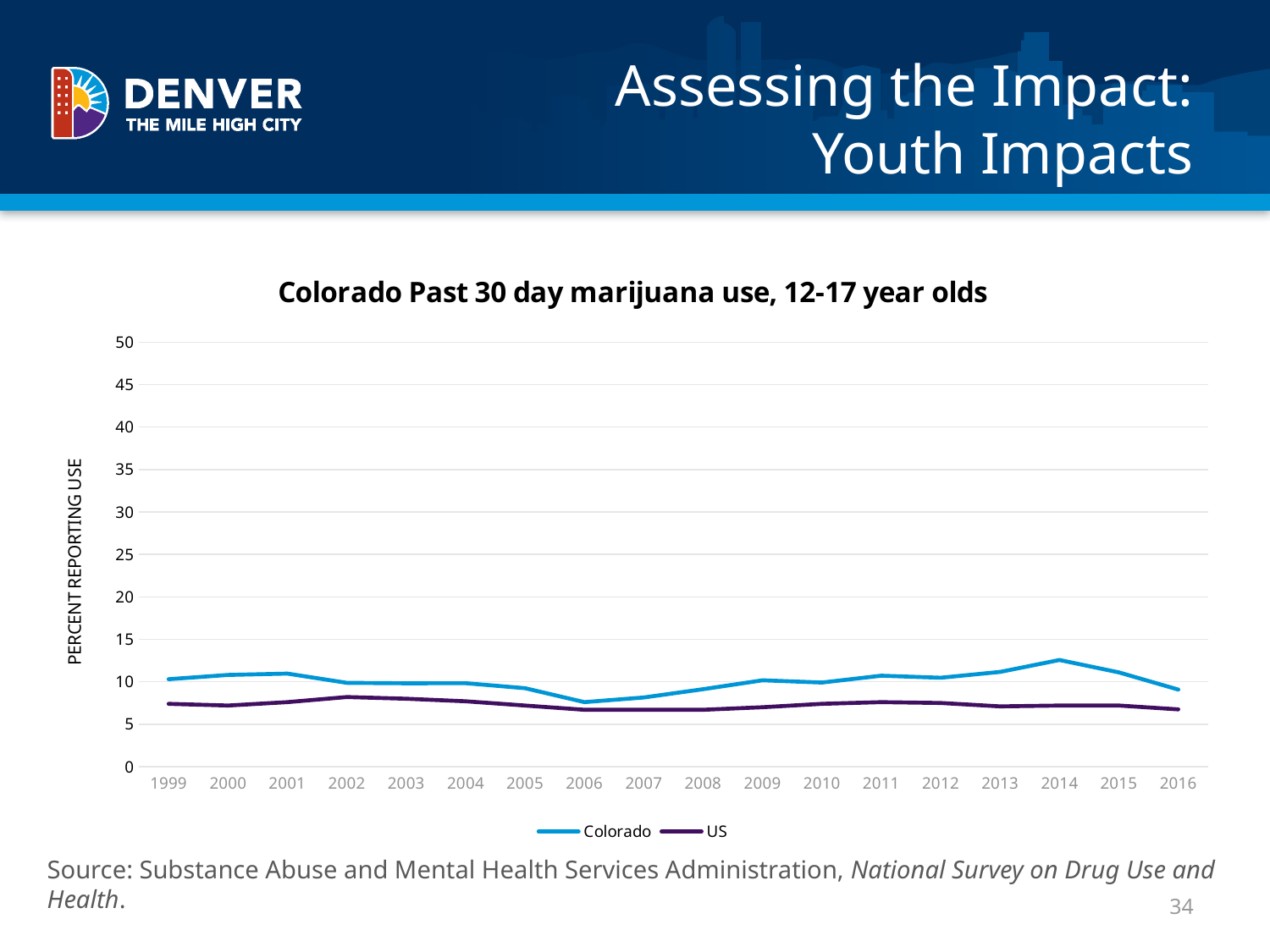
In which year does the Colorado line reach its lowest value? 2006 Is the value for Colorado in 2006 greater or less than 10? less In 2014, which series has the higher value, Colorado or US? Colorado How many years are plotted along the x axis? 18 In which year does the Colorado line reach its highest value? 2014 What is the title of the chart? Colorado Past 30 day marijuana use, 12-17 year olds Which two series are shown in the legend? Colorado and US What kind of chart is shown on the slide? line chart Is the value for US in 2016 greater or less than 10? less How many series does the legend list? 2 Does the Colorado line rise or fall from 2014 to 2016? fall Is the value for Colorado in 2014 greater or less than 10? greater